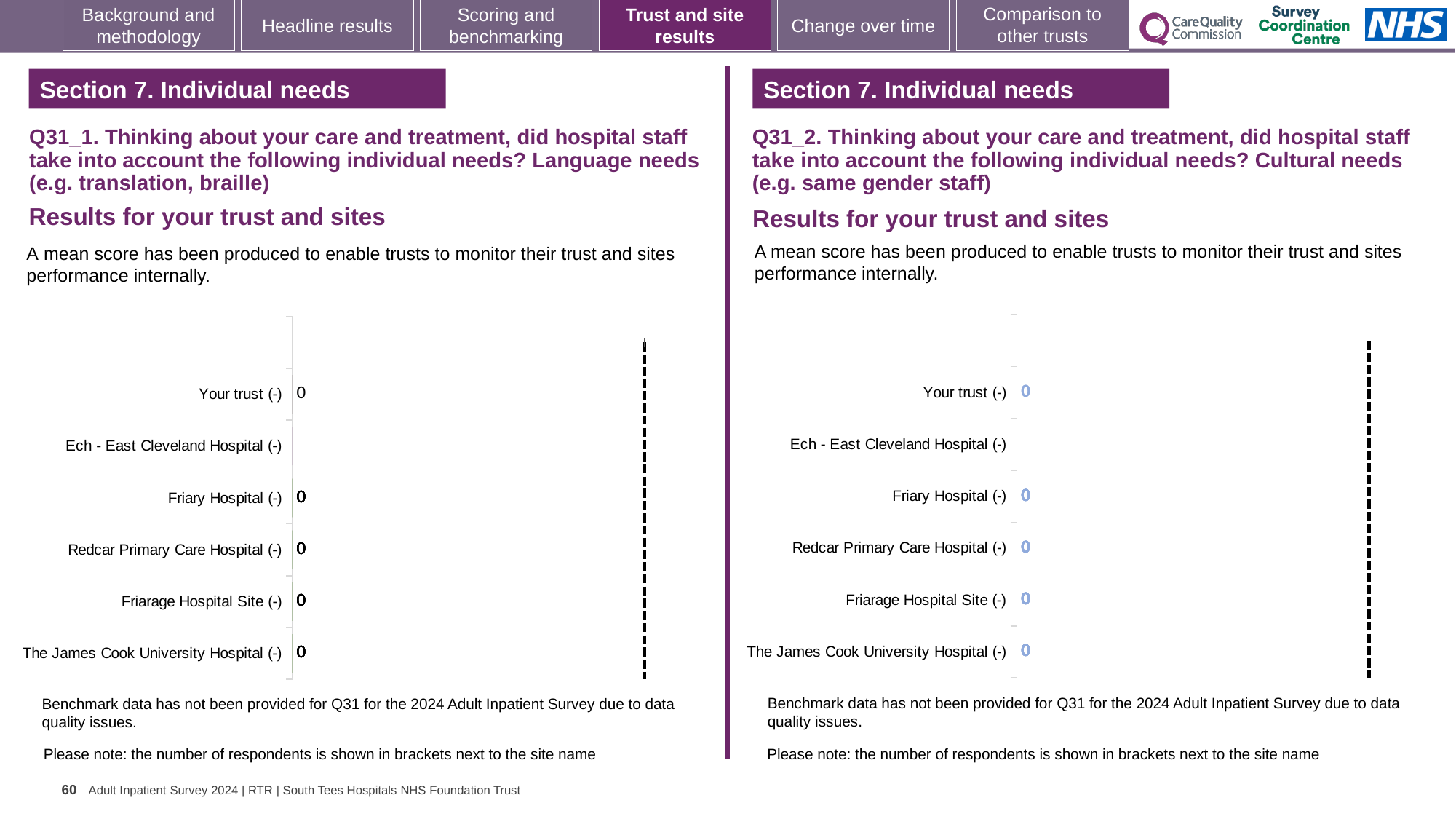
In the right chart (Q31_2, Cultural needs), what is the value shown for Your trust (-)? 0 In the right chart (Q31_2, Cultural needs), what is the difference between the values for Friarage Hospital Site (-) and The James Cook University Hospital (-)? 0 In the left chart (Q31_1, Language needs), what is the difference between the values for Your trust (-) and Friary Hospital (-)? 0 In the right chart (Q31_2, Cultural needs), what is the value shown for Redcar Primary Care Hospital (-)? 0 How many categories are listed on the vertical axis of the right chart (Q31_2, Cultural needs)? 6 In the left chart (Q31_1, Language needs), what is the value shown for Friarage Hospital Site (-)? 0 In the left chart (Q31_1, Language needs), what is the value shown for Your trust (-)? 0 Which category in the right chart (Q31_2, Cultural needs) has no data label shown next to it? Ech - East Cleveland Hospital (-) What kind of chart is the left chart (Q31_1, Language needs)? Bar chart In the left chart (Q31_1, Language needs), what is the value shown for The James Cook University Hospital (-)? 0 How many categories are listed on the vertical axis of the left chart (Q31_1, Language needs)? 6 In the right chart (Q31_2, Cultural needs), what is the value shown for Friary Hospital (-)? 0